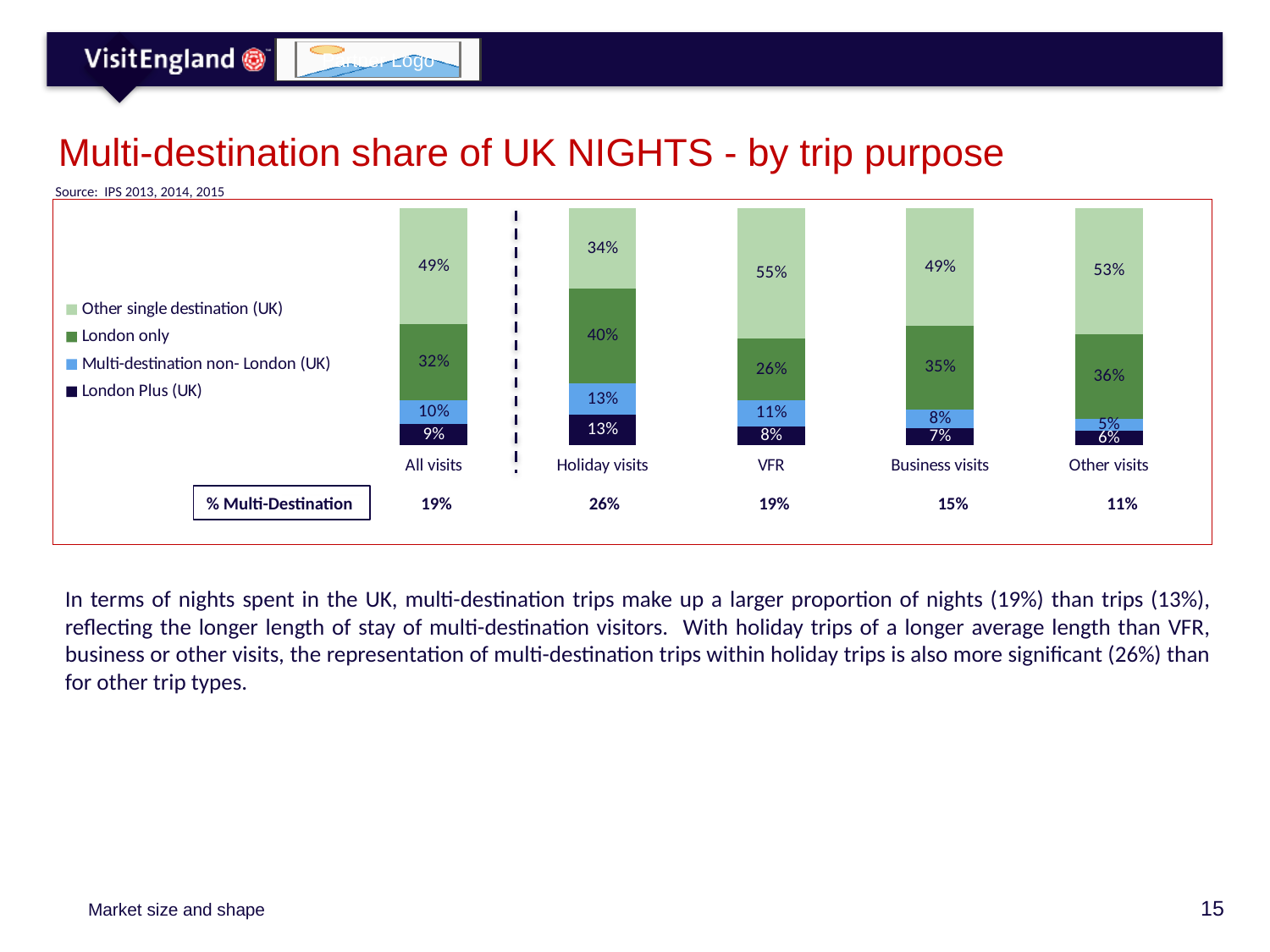
Which is larger: the London Plus (UK) value for Holiday visits or for All visits? Holiday visits What is the difference between the Other single destination (UK) values for VFR and Holiday visits? 21% What is the value for Multi-destination non- London (UK) for Other visits? 5% What kind of chart is shown on the slide? Stacked bar chart What is the value for London Plus (UK) for Business visits? 7% What is the value for Other single destination (UK) for VFR? 55% What is the % Multi-Destination figure shown for Holiday visits? 26% What is the value for London only for Holiday visits? 40% Which category has the lowest value for Other single destination (UK)? Holiday visits How many categories are shown on the x axis? 5 How many series does the legend list? 4 Which category has the highest value for London only? Holiday visits